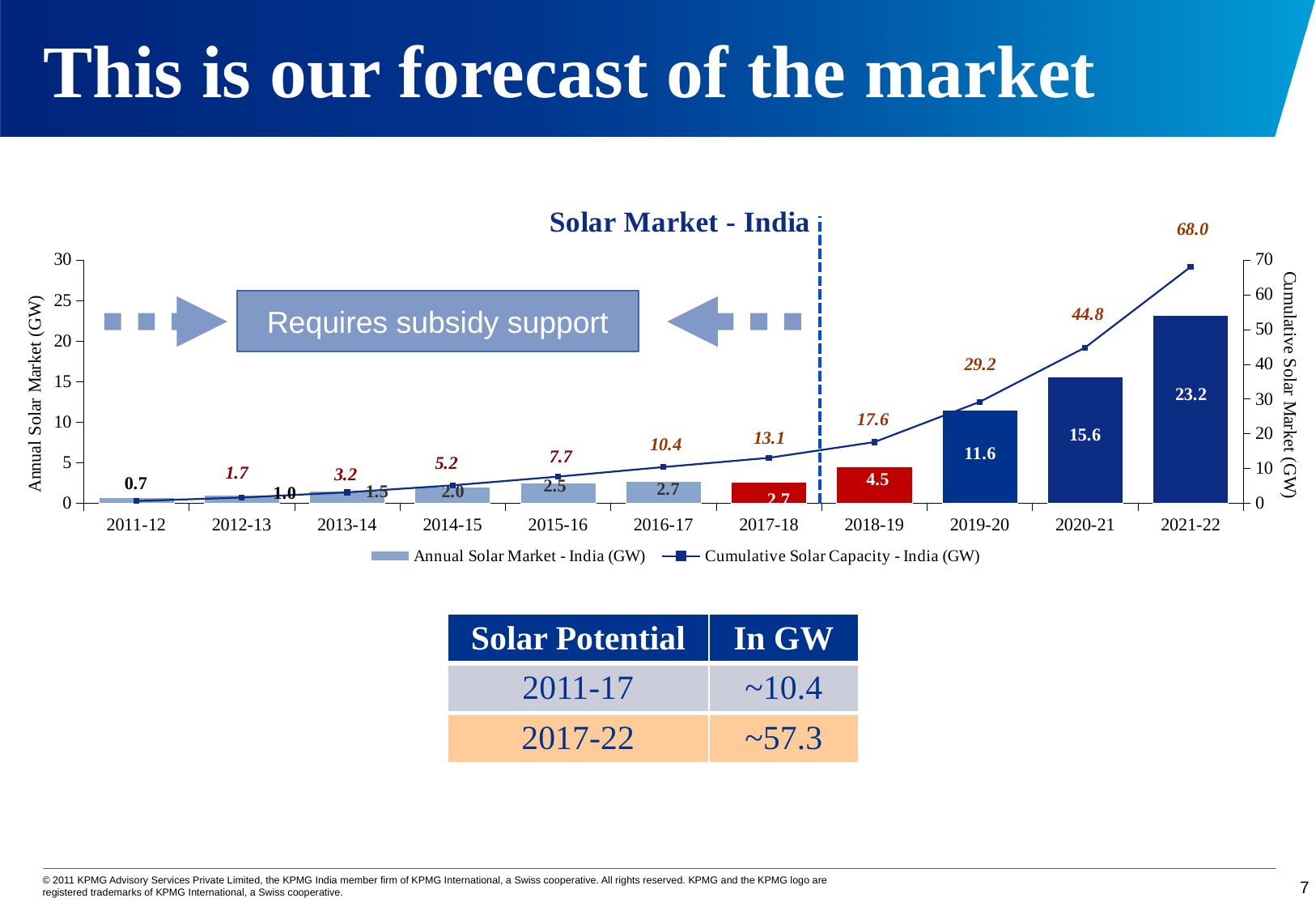
What is the Annual Solar Market - India (GW) value for 2021-22? 23.2 What is the Cumulative Solar Capacity - India (GW) value for 2019-20? 29.2 What is the difference between the Annual Solar Market values for 2021-22 and 2020-21? 7.6 Which year has the highest Annual Solar Market - India (GW) value? 2021-22 How many series does the chart legend list? 2 How many year categories are shown on the x axis of the chart? 11 Which year has the lowest Annual Solar Market - India (GW) value? 2011-12 What is the Cumulative Solar Capacity - India (GW) value for 2021-22? 68.0 What is the Annual Solar Market - India (GW) value for 2018-19? 4.5 Which is larger, the Cumulative Solar Capacity for 2016-17 or for 2017-18? 2017-18 What is the title of the chart on the slide? Solar Market - India Does the Cumulative Solar Capacity - India (GW) rise or fall from 2012-13 to 2021-22? rise